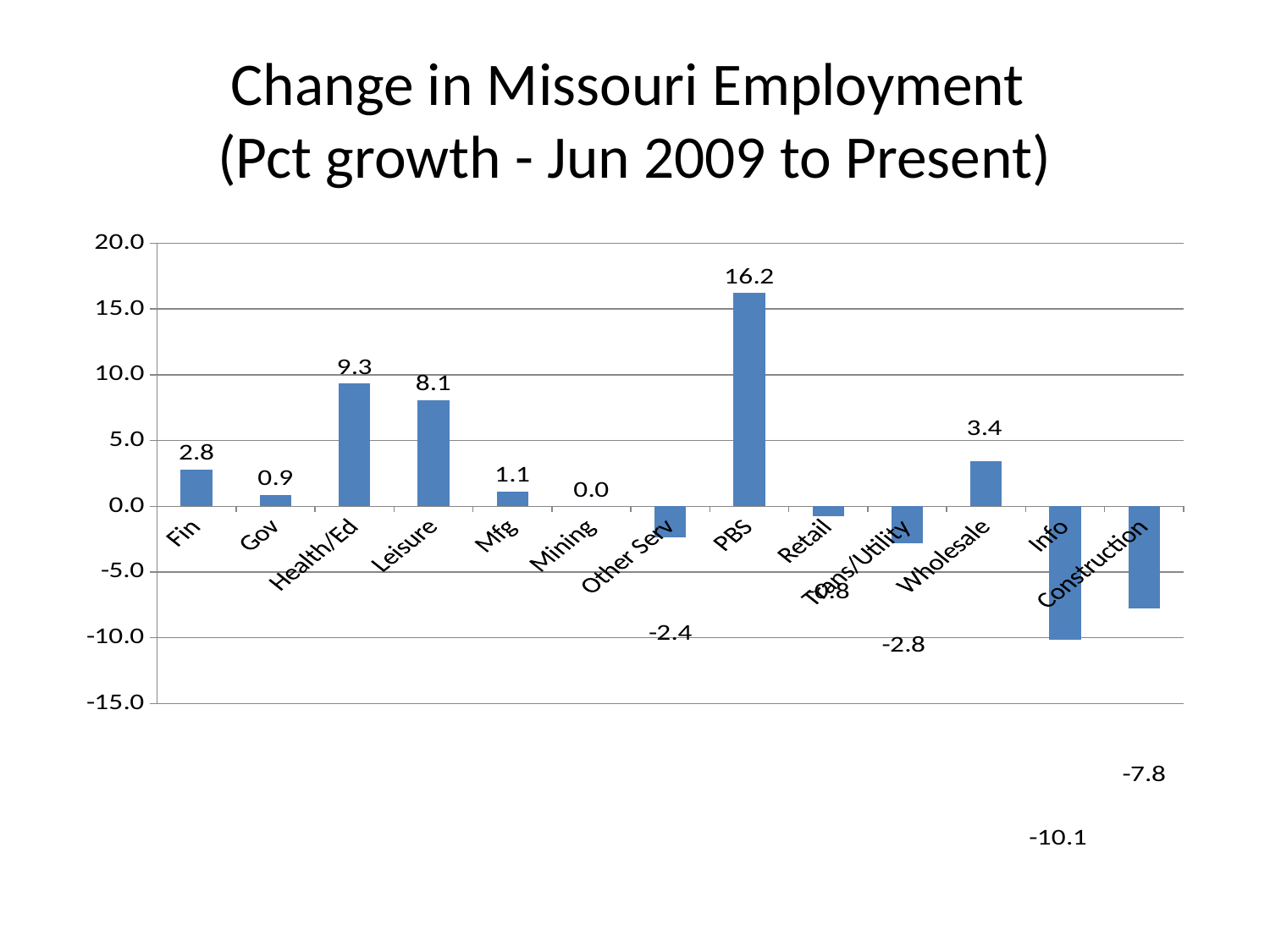
What is the difference between the values for Health/Ed and Leisure? 1.2 What is the value for Mining? 0.0 Which category has the lowest value? Info Which category has the highest value? PBS Is the value for Retail greater or less than 0.0? less What is the value for Other Serv? -2.4 Which is larger, the value for Fin or the value for Wholesale? Wholesale What is the title of the chart? Change in Missouri Employment (Pct growth - Jun 2009 to Present) What is the value for Health/Ed? 9.3 What is the value for PBS? 16.2 What kind of chart is this? bar chart How many categories are shown on the x axis? 13